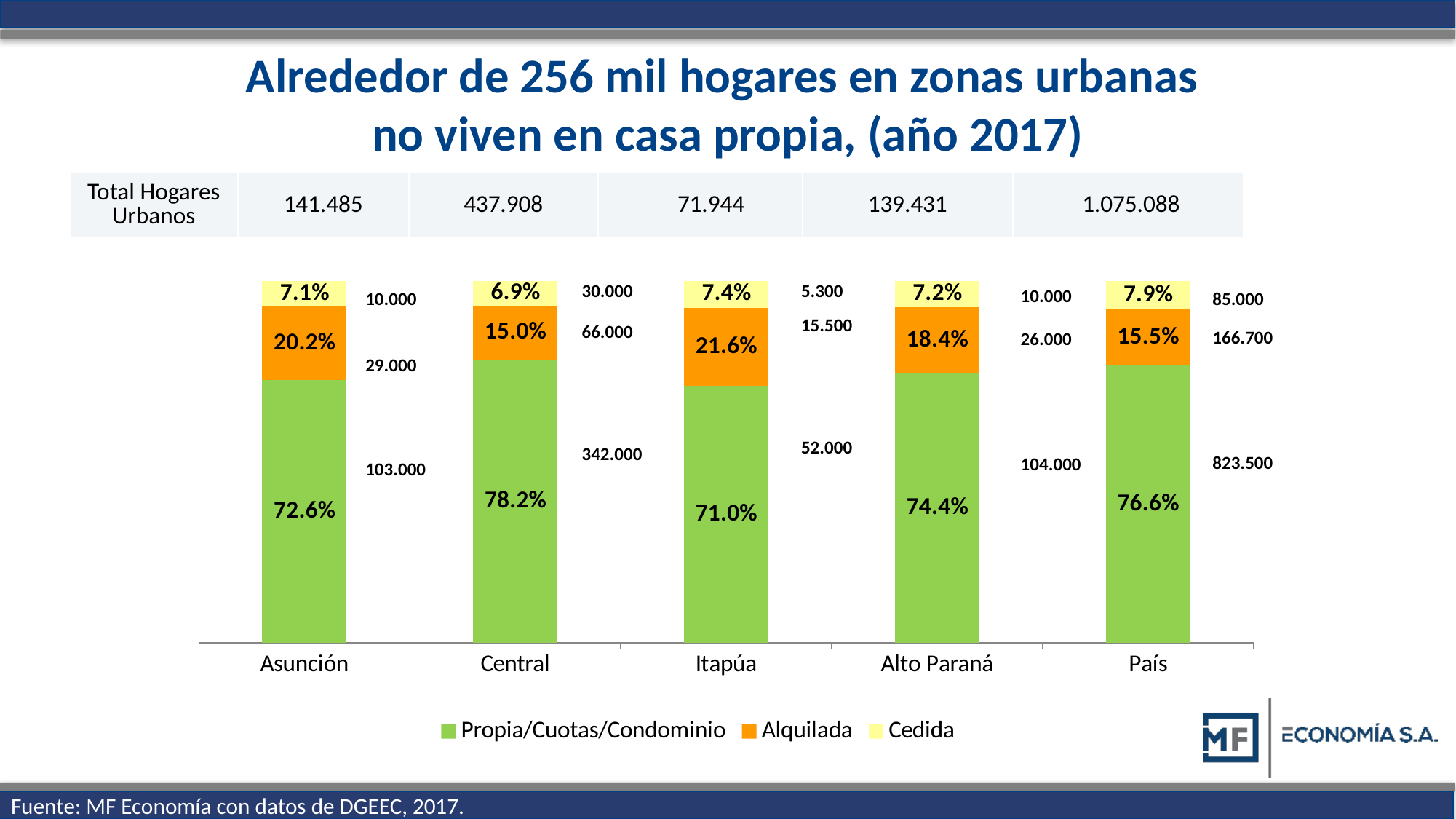
What is the Alquilada share for Itapúa? 21.6% How many categories are shown on the x axis? 5 What kind of chart is shown on the slide? Stacked bar chart What is the Cedida percentage for País? 7.9% Which category has the lowest Propia/Cuotas/Condominio percentage? Itapúa Which category has the highest Propia/Cuotas/Condominio percentage? Central What number of households is shown next to the Alquilada segment for Central? 66.000 How many series does the legend list? 3 Which has a larger Alquilada share, Alto Paraná or País? Alto Paraná Which colour represents the Cedida series in the legend? Light yellow What percentage of urban households in Asunción are Propia/Cuotas/Condominio? 72.6% What is the difference in percentage points between the Alquilada share in Asunción and in Central? 5.2